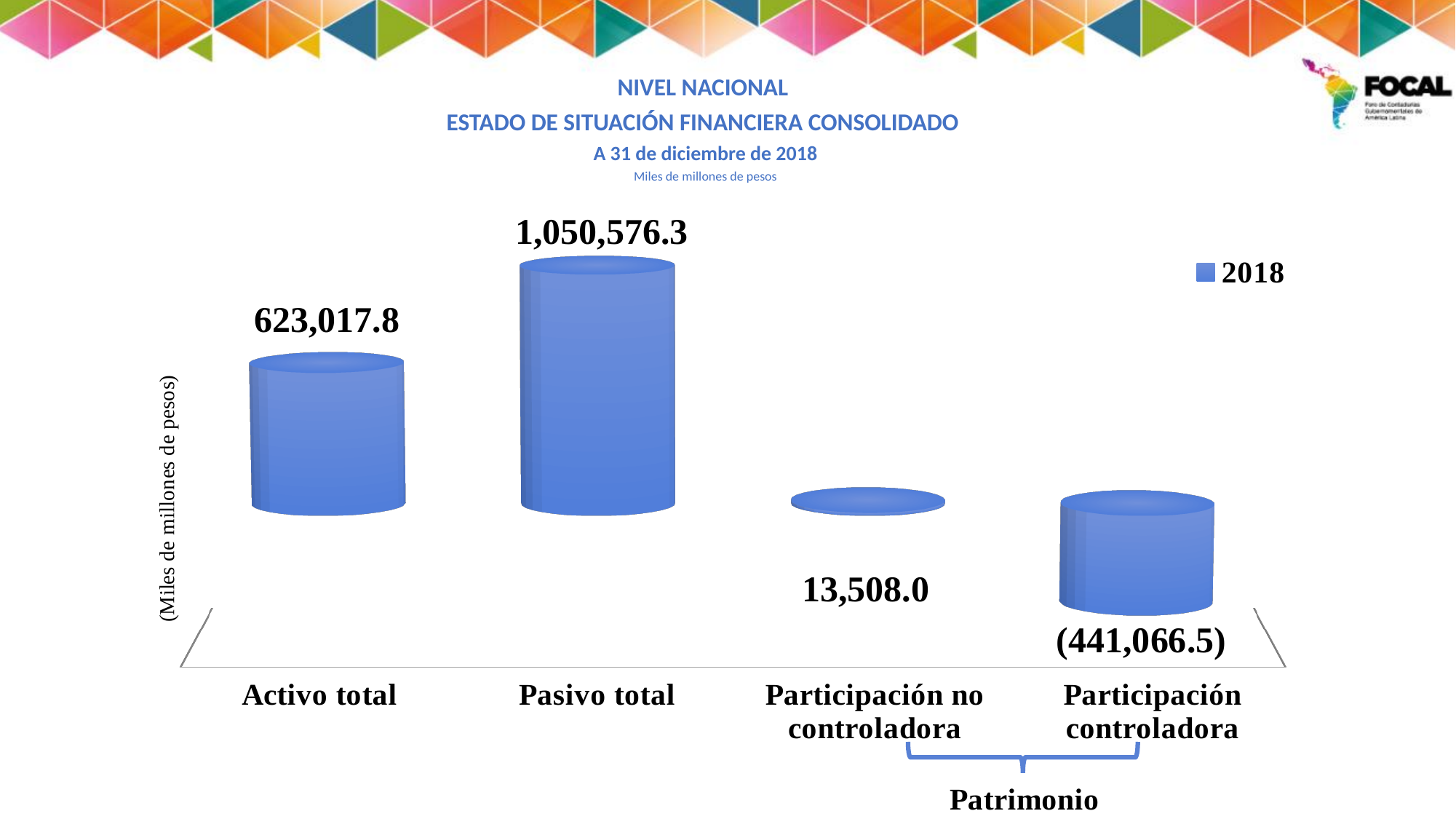
Which category has the highest value? Pasivo total What is the value for Participación controladora? (441,066.5) What is the difference between Pasivo total and Activo total? 427,558.5 How many series does the legend list? 1 Which category has the lowest value? Participación controladora How many categories are shown on the x axis? 4 What is the value for Pasivo total? 1,050,576.3 What is the value for Activo total? 623,017.8 What is the value for Participación no controladora? 13,508.0 What kind of chart is shown on the slide? Bar chart What year does the legend entry show? 2018 Which is larger, Activo total or Pasivo total? Pasivo total